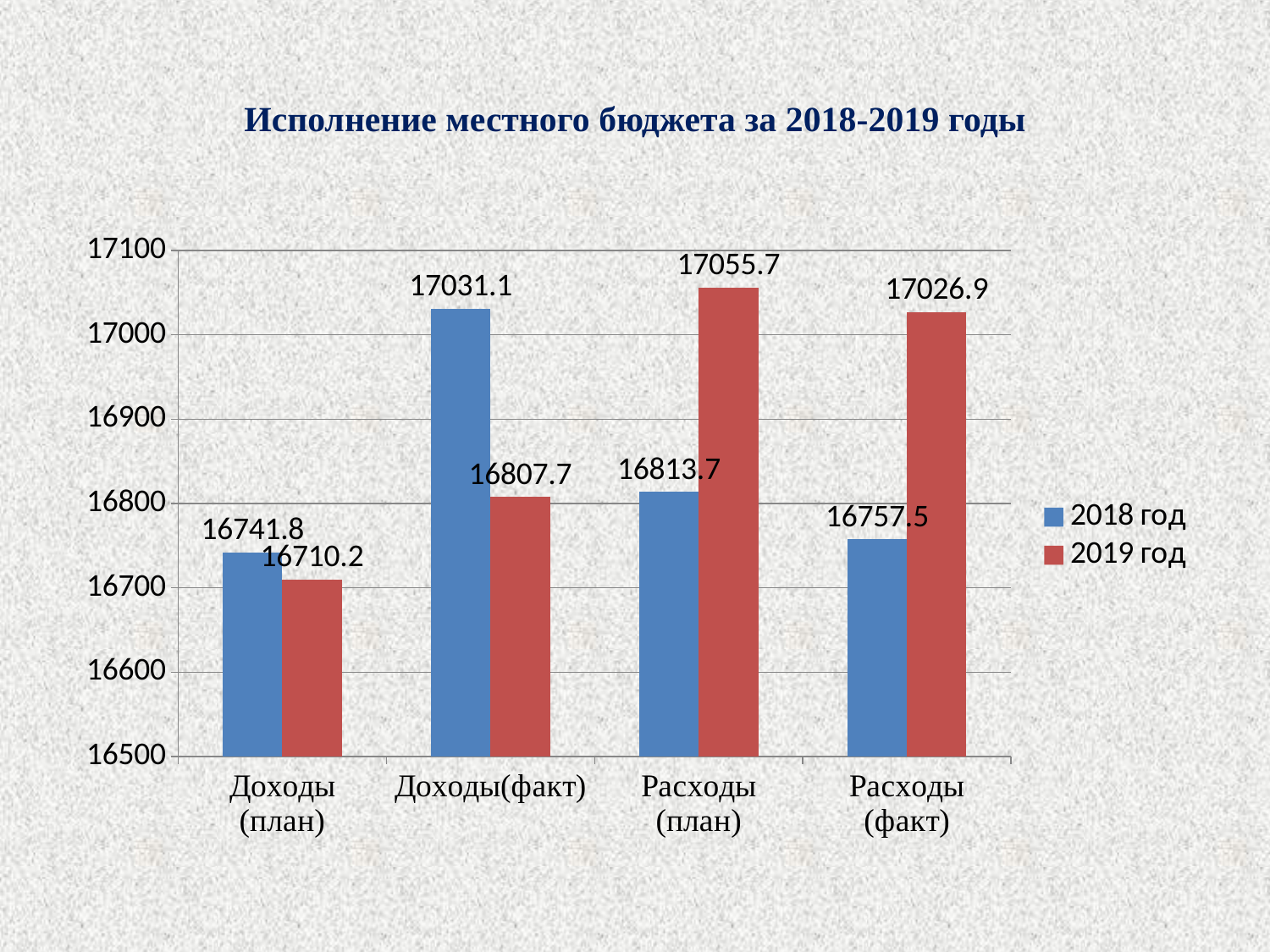
What is the value for 2018 год in the Расходы (факт) category? 16757.5 What type of chart is shown on the slide? Bar chart What is the value for 2019 год in the Расходы (план) category? 17055.7 How many categories are shown on the x axis? 4 Is the value for 2019 год in Расходы (факт) greater or less than 17000? greater Which category has the lowest value for the 2018 год series? Доходы (план) What is the value for 2018 год in the Доходы(факт) category? 17031.1 What is the difference between the 2019 год and 2018 год values in the Расходы (план) category? 242.0 Which category has the highest value for the 2019 год series? Расходы (план) Which is larger in the Доходы(факт) category: the 2018 год value or the 2019 год value? 2018 год What is the value for 2019 год in the Доходы (план) category? 16710.2 How many series does the legend list? 2